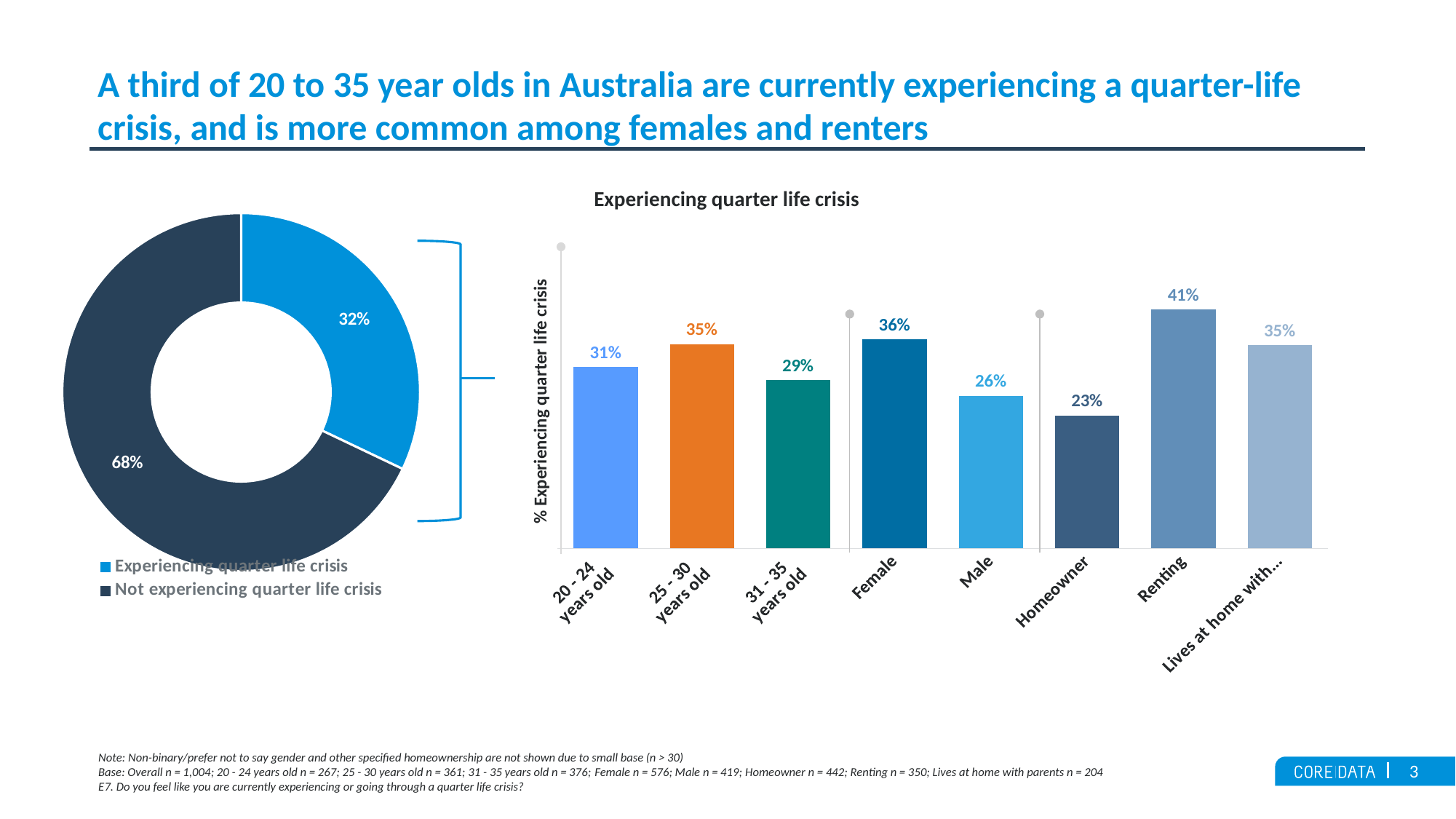
What kind of chart is the chart on the right of the slide? Bar chart In the donut chart on the left, what share of respondents are not experiencing a quarter life crisis? 68% In the 'Experiencing quarter life crisis' bar chart, what is the value for Homeowner? 23% In the 'Experiencing quarter life crisis' bar chart, what is the value for 25 - 30 years old? 35% In the 'Experiencing quarter life crisis' bar chart, what is the difference between the values for Female and Male? 10% In the donut chart on the left, what share of respondents are experiencing a quarter life crisis? 32% In the 'Experiencing quarter life crisis' bar chart, which category has the lowest value? Homeowner What is the title of the bar chart on the right of the slide? Experiencing quarter life crisis How many entries does the legend of the donut chart on the left list? 2 In the 'Experiencing quarter life crisis' bar chart, which is larger, the value for 20 - 24 years old or the value for 31 - 35 years old? 20 - 24 years old In the 'Experiencing quarter life crisis' bar chart, what is the value for Renting? 41% In the 'Experiencing quarter life crisis' bar chart, which category has the highest value? Renting